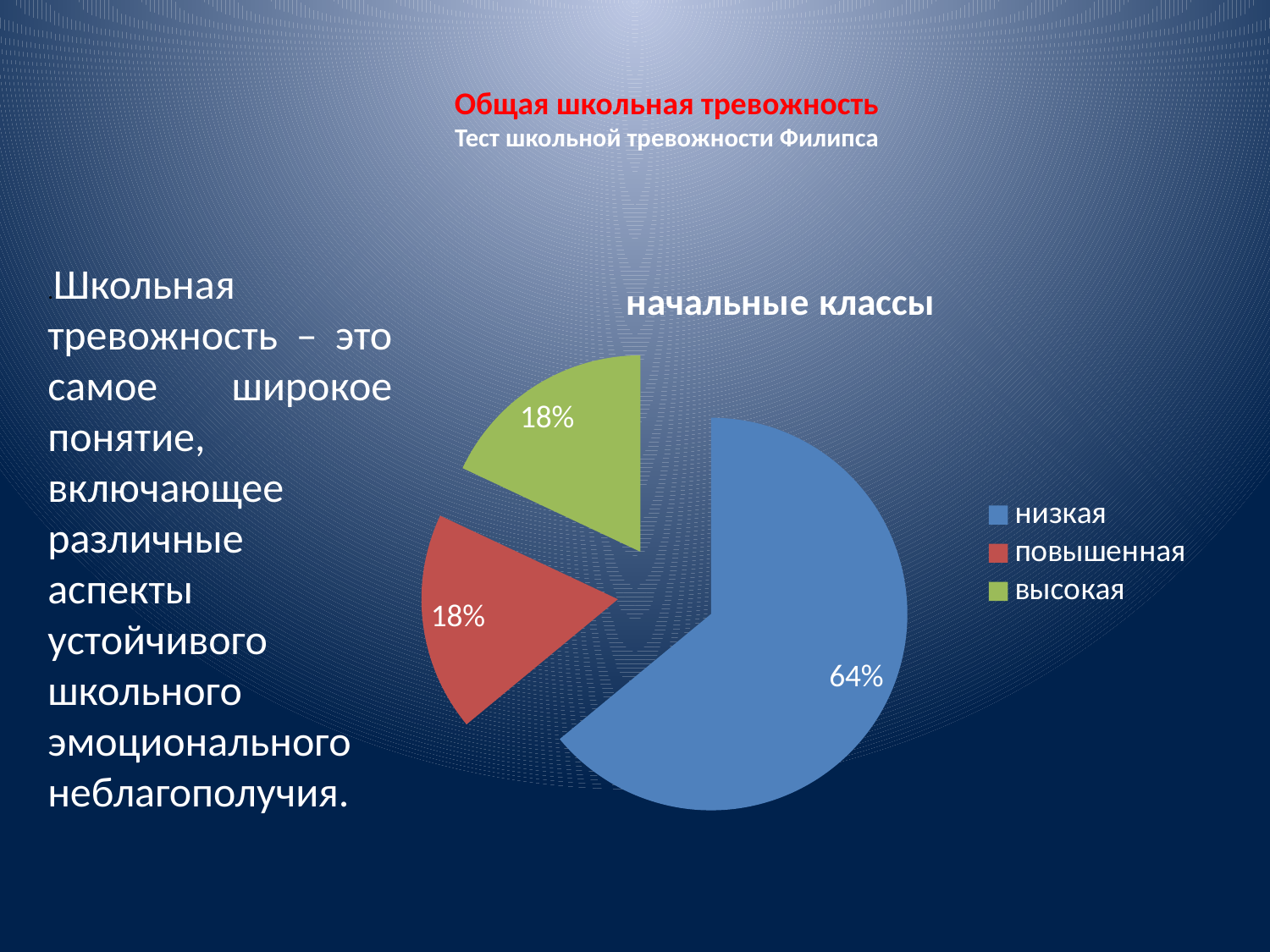
Which is larger, the share for 'низкая' or the share for 'повышенная'? низкая What colour is the 'высокая' slice in the pie chart? green What share of the pie does the 'низкая' category have? 64% What share of the pie does the 'повышенная' category have? 18% How many entries does the legend list? 3 What type of chart is shown on the slide? pie chart Which category has the largest slice of the pie? низкая What is the title of the chart? начальные классы What share of the pie does the 'высокая' category have? 18% How many slices does the pie chart have? 3 What is the difference between the 'низкая' share and the 'высокая' share? 46% Is the share for 'низкая' greater or less than 50%? greater